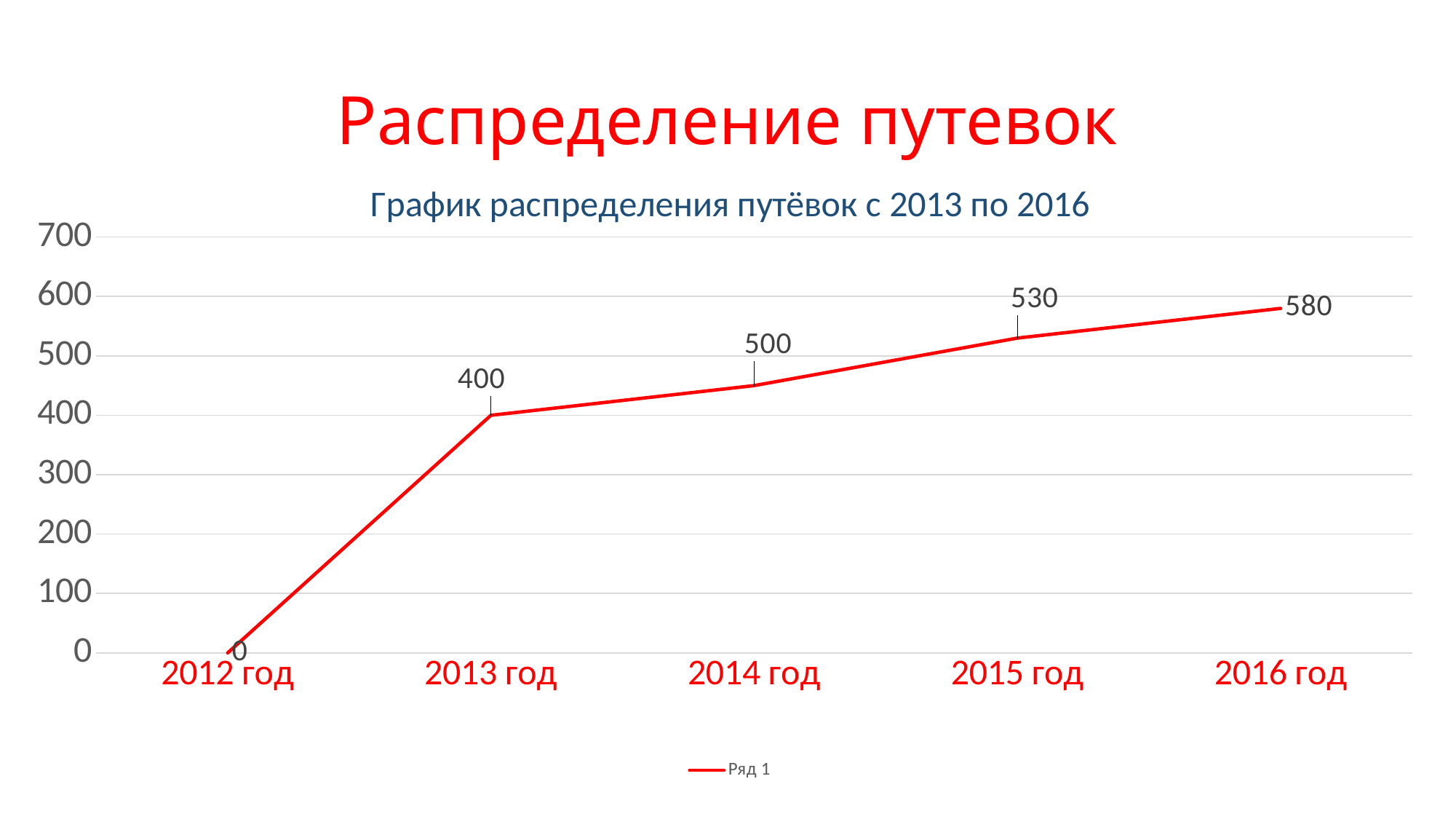
What is the value for 2015 год? 530 How many years are plotted on the x axis? 5 What kind of chart is shown? line chart What is the value for 2016 год? 580 What is the value for 2013 год? 400 What is the value for 2012 год? 0 How many series does the legend list? 1 Do the values rise or fall from 2012 год to 2016 год? rise Which is larger, the value for 2014 год or the value for 2015 год? 2015 год Which year has the highest value? 2016 год Which year has the lowest value? 2012 год